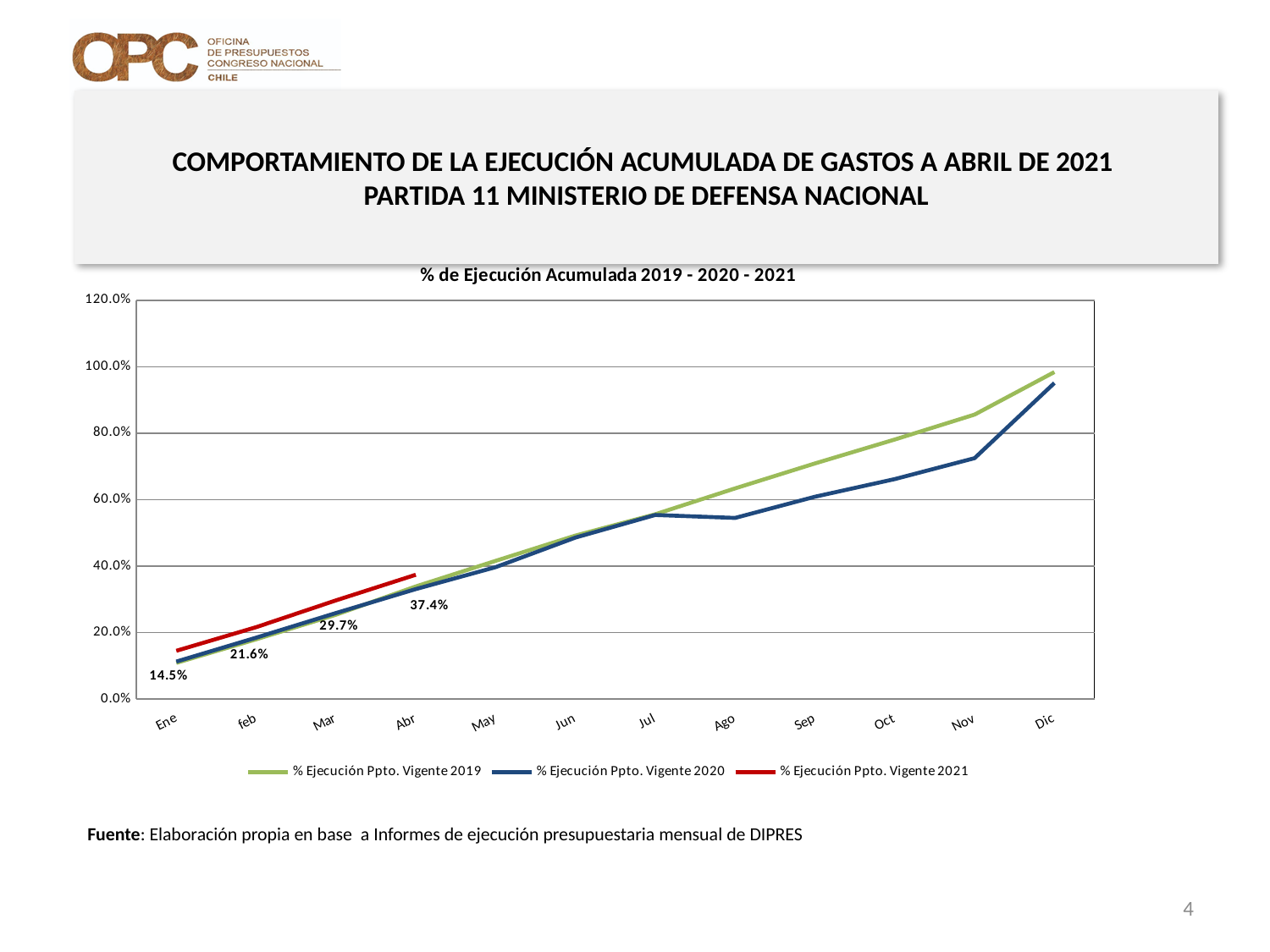
In Nov, which series is higher: % Ejecución Ppto. Vigente 2019 or % Ejecución Ppto. Vigente 2020? % Ejecución Ppto. Vigente 2019 By how many percentage points did % Ejecución Ppto. Vigente 2021 increase from Ene to Abr? 22.9 percentage points What is the value of % Ejecución Ppto. Vigente 2021 for Abr? 37.4% What is the value of % Ejecución Ppto. Vigente 2021 for Ene? 14.5% How many series does the legend list? 3 What is the title of the chart? % de Ejecución Acumulada 2019 - 2020 - 2021 What is the difference between the 2021 values for Mar and Feb? 8.1 percentage points How many months are shown on the x axis? 12 What kind of chart is shown on the slide? Line chart Does the % Ejecución Ppto. Vigente 2021 line rise or fall from Ene to Abr? Rises Is the value for % Ejecución Ppto. Vigente 2020 in Nov greater or less than 80.0%? less What is the value of % Ejecución Ppto. Vigente 2021 for Mar? 29.7%